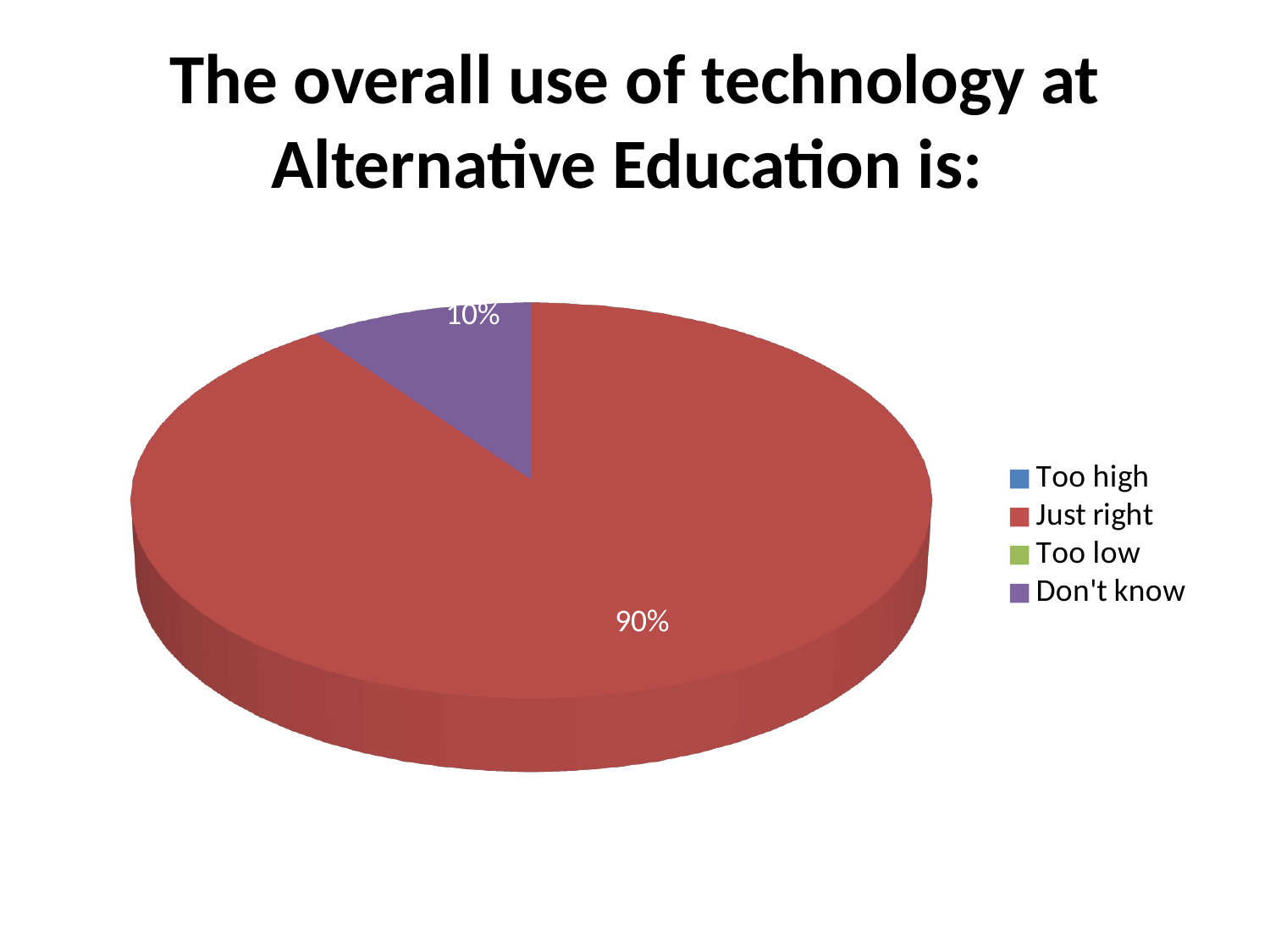
What kind of chart is shown on the slide? Pie chart What share of the pie does "Just right" take? 90% How many slices are visible in the pie? 2 What share of the pie does "Don't know" take? 10% What is the difference between the "Just right" share and the "Don't know" share? 80% Which category has the largest slice of the pie? Just right Which is larger, the share for "Just right" or the share for "Don't know"? Just right What is the title of the chart? The overall use of technology at Alternative Education is: What colour is the "Just right" slice? Red How many categories does the legend list? 4